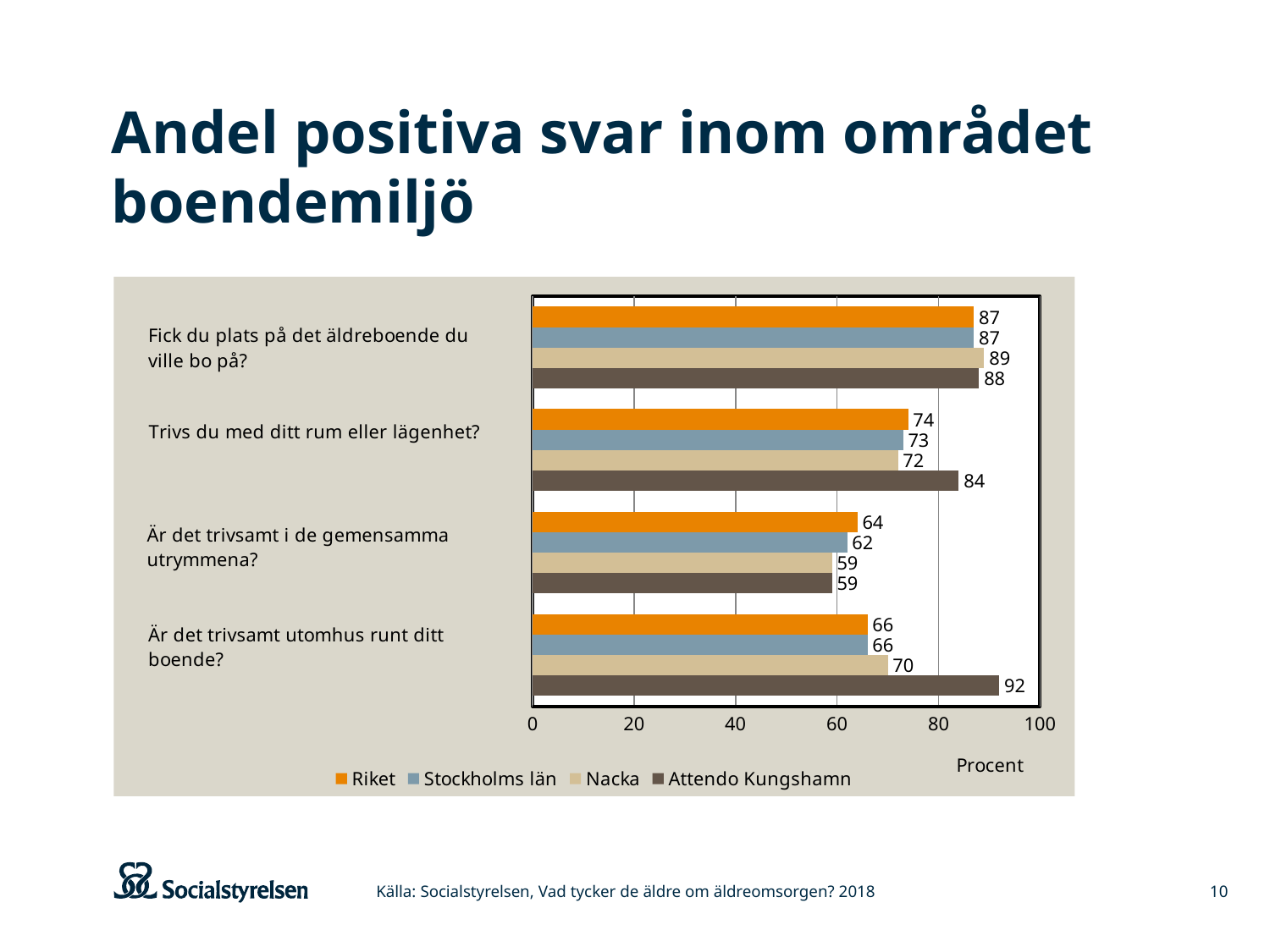
Which series has the lowest value for "Är det trivsamt utomhus runt ditt boende?"? Riket and Stockholms län (both 66) Which is larger for "Är det trivsamt i de gemensamma utrymmena?": Riket or Nacka? Riket What is the value for Riket for "Trivs du med ditt rum eller lägenhet?"? 74 How many series does the legend list? 4 What label is shown on the horizontal axis of the chart? Procent What kind of chart is shown on the slide? Bar chart How many question categories are plotted on the chart? 4 What is the difference between Attendo Kungshamn and Nacka for "Är det trivsamt utomhus runt ditt boende?"? 22 Which series has the highest value for "Trivs du med ditt rum eller lägenhet?"? Attendo Kungshamn What is the value for Attendo Kungshamn for "Är det trivsamt utomhus runt ditt boende?"? 92 What is the value for Nacka for "Fick du plats på det äldreboende du ville bo på?"? 89 What is the value for Stockholms län for "Är det trivsamt i de gemensamma utrymmena?"? 62